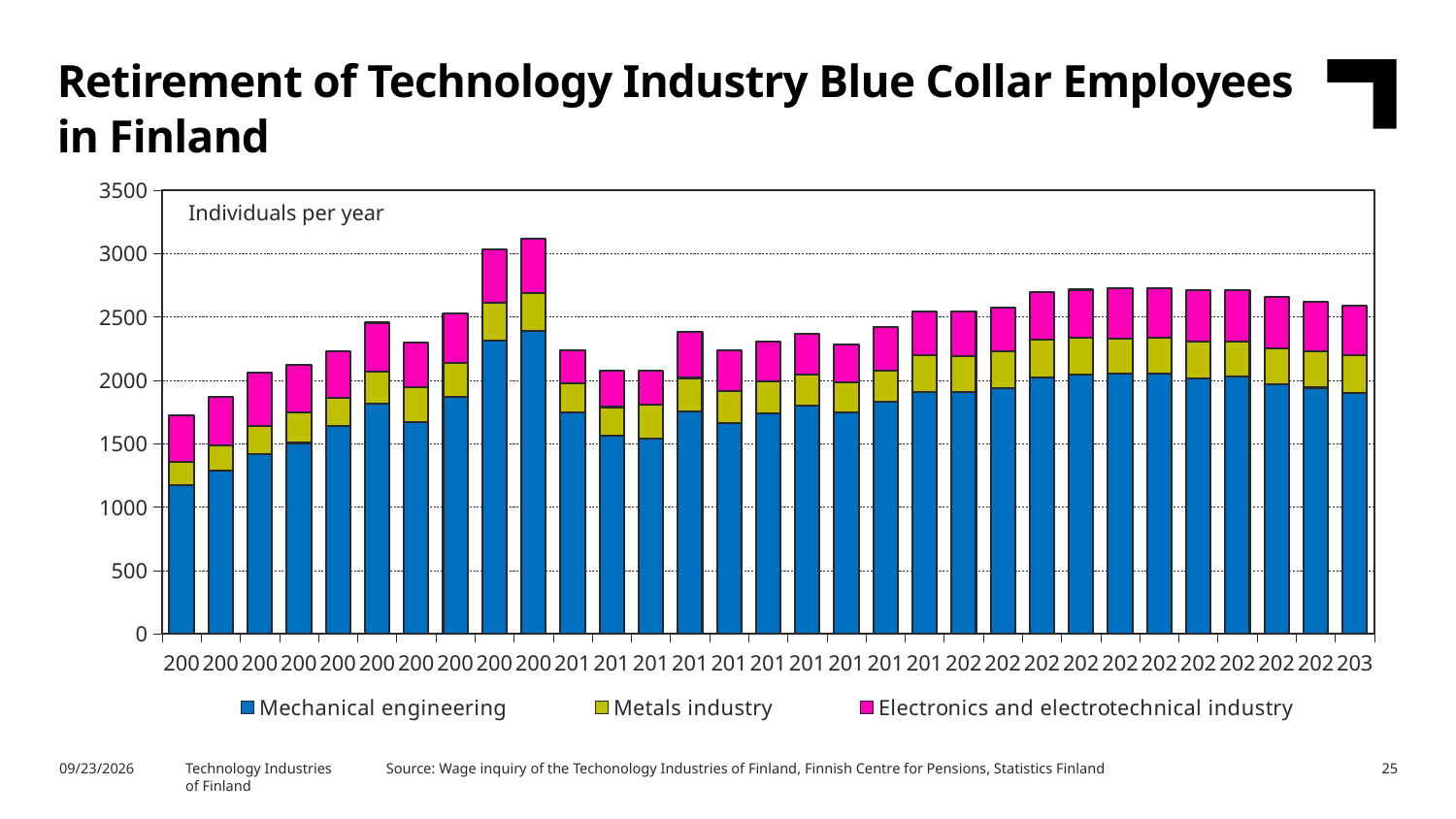
Is the total of the rightmost bar greater or less than 2500? greater Is the Mechanical engineering value in the leftmost bar greater or less than 1000? greater What kind of chart is shown on the slide? Stacked bar chart How many bars are plotted in the chart? 31 How many series does the legend list? 3 What unit label is shown inside the plot area? Individuals per year Which series makes up the smallest part of the leftmost bar? Metals industry Which bar has the larger total, the leftmost bar or the rightmost bar? The rightmost bar Is the total of the leftmost bar greater or less than 2000? less What are the three series listed in the legend? Mechanical engineering, Metals industry, Electronics and electrotechnical industry Which series makes up the largest part of every bar? Mechanical engineering